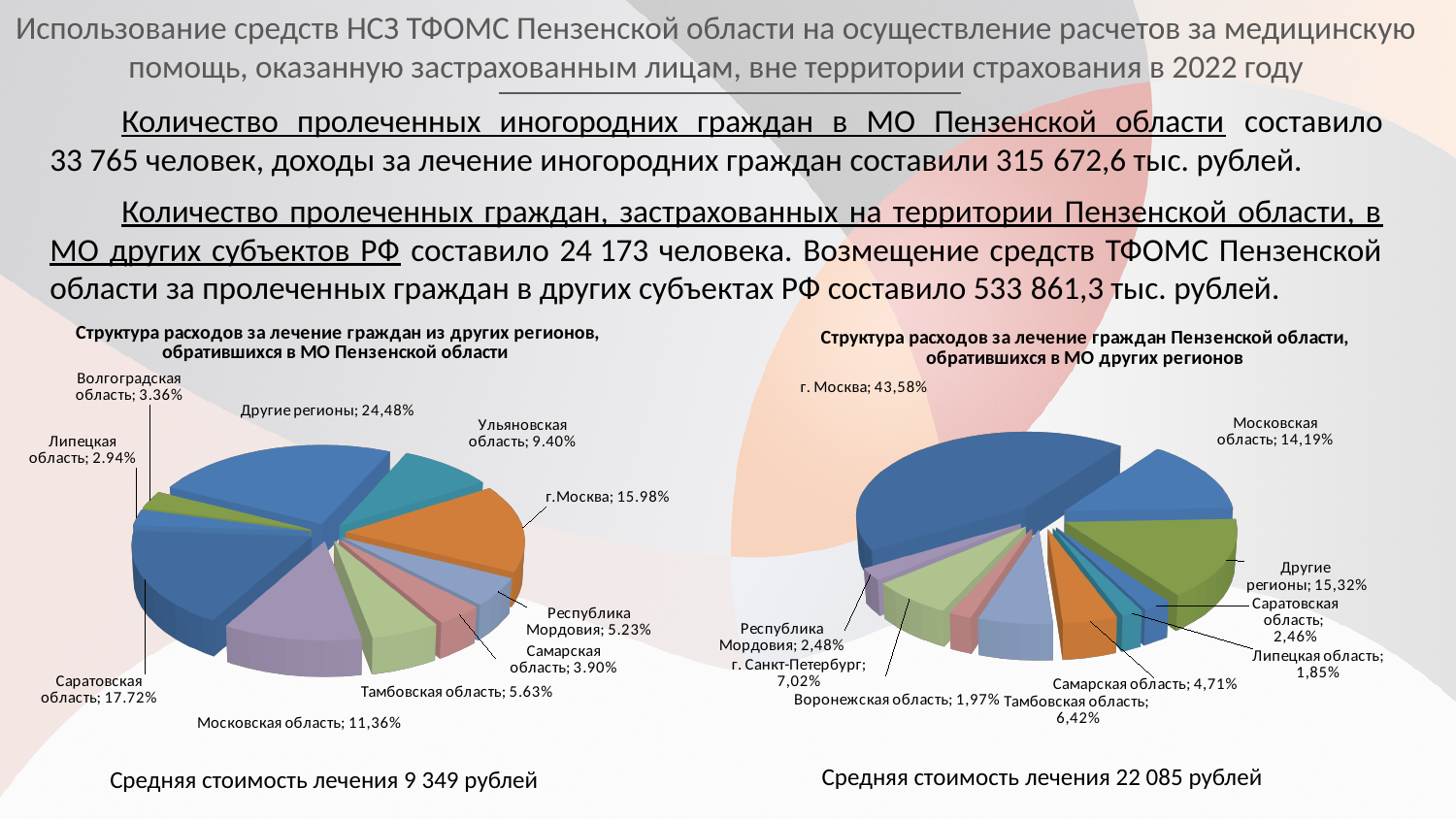
In the right pie chart, what is the difference between the shares of Другие регионы and Московская область? 1,13% In the left pie chart, which category has the largest share? Другие регионы In the right pie chart, which category has the smallest share? Липецкая область In the left pie chart, which category has the smallest share? Липецкая область In the left pie chart, which is larger: the share for Ульяновская область or for Московская область? Московская область In the right pie chart (Структура расходов за лечение граждан Пензенской области, обратившихся в МО других регионов), what share is shown for г. Москва? 43,58% In the left pie chart, what share is shown for г.Москва? 15.98% In the right pie chart, which category has the largest share? г. Москва What type of chart is used on the right side of the slide? Pie chart In the right pie chart, what share is shown for Тамбовская область? 6,42% In the left pie chart, how many slices (categories) are shown? 10 In the left pie chart (Структура расходов за лечение граждан из других регионов, обратившихся в МО Пензенской области), what share is shown for Саратовская область? 17.72%